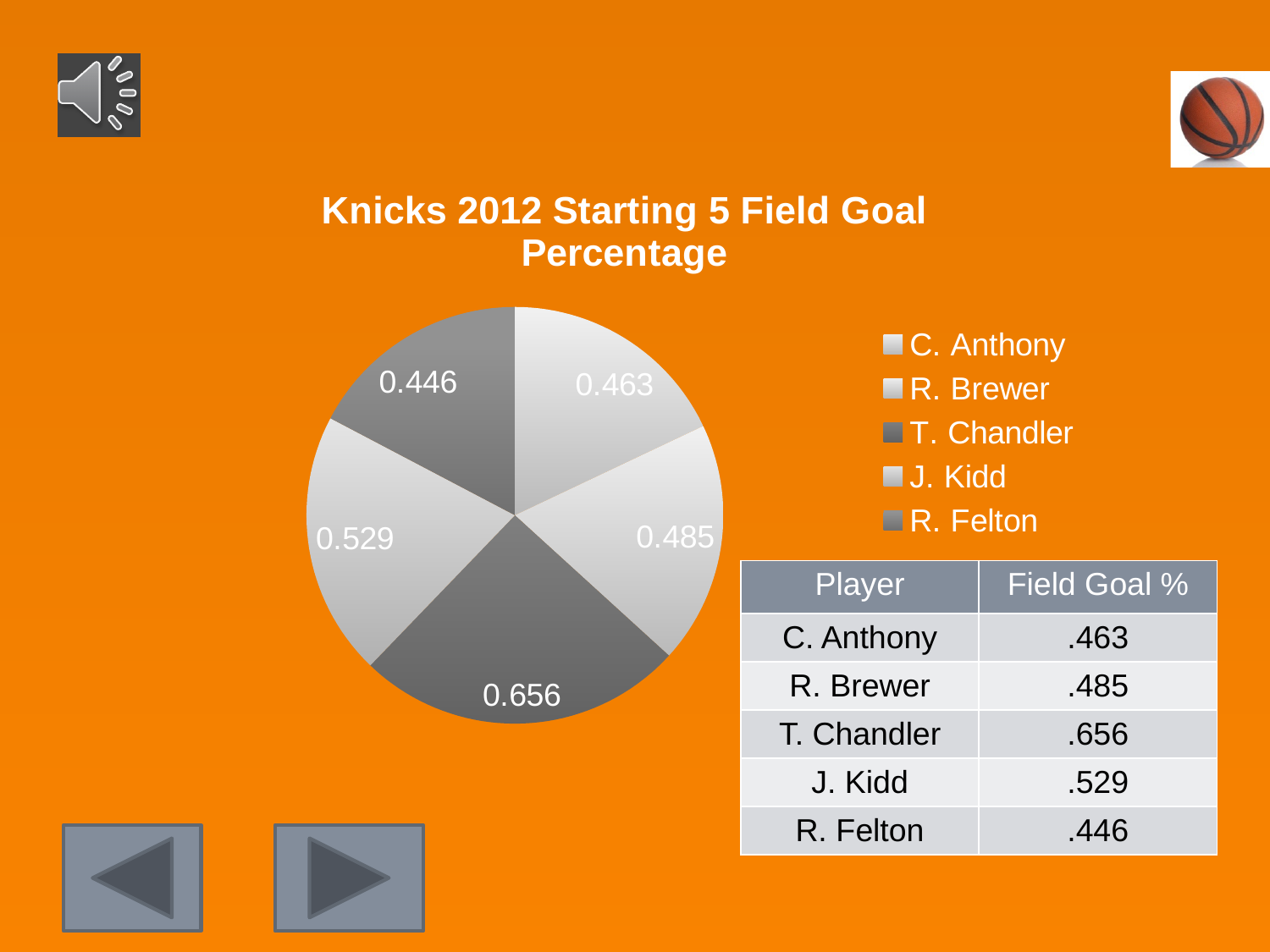
What is the value shown for J. Kidd in the pie chart? 0.529 What is the title of the chart? Knicks 2012 Starting 5 Field Goal Percentage Which player has the smallest slice in the pie chart? R. Felton Which player has the largest slice in the pie chart? T. Chandler What type of chart is shown on the slide? Pie chart What is the difference between the values for J. Kidd and R. Brewer in the pie chart? 0.044 What is the difference between the values for T. Chandler and R. Felton in the pie chart? 0.210 What is the value shown for C. Anthony in the pie chart? 0.463 Which is larger in the pie chart, the value for J. Kidd or the value for C. Anthony? J. Kidd What is the value shown for R. Felton in the pie chart? 0.446 What is the value shown for T. Chandler in the pie chart? 0.656 How many slices does the pie chart have? 5